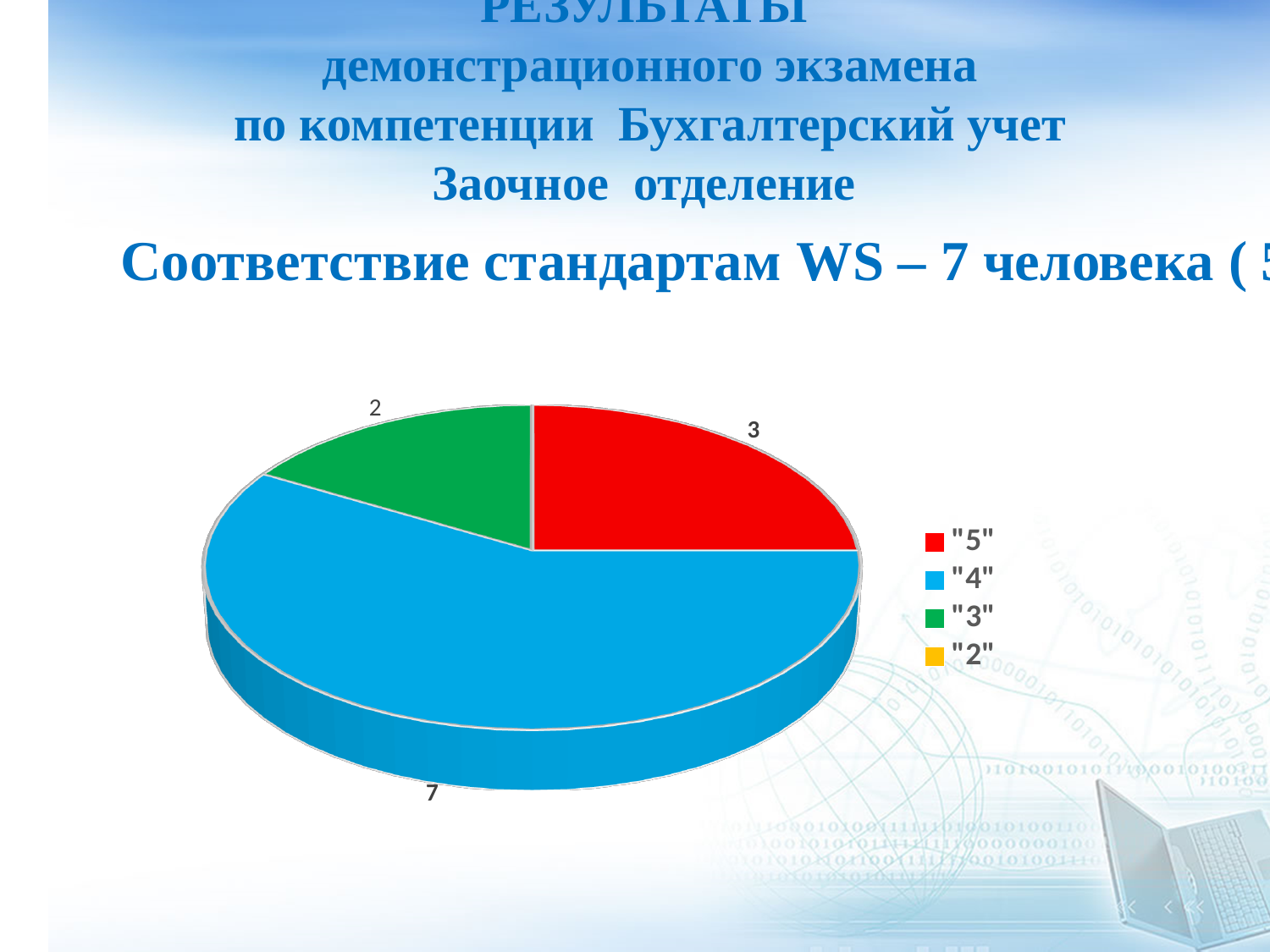
What is the value of the "5" slice in the pie chart? 3 Which slice is larger, "5" or "3"? "5" What is the value of the "3" slice in the pie chart? 2 How many slices with data labels are visible in the pie chart? 3 What share of the pie does the "5" slice represent? 25% What type of chart is shown on the slide? pie chart Which grade has the largest slice in the pie chart? "4" What is the value of the "4" slice in the pie chart? 7 How many entries does the legend of the pie chart list? 4 What is the difference between the values of the "4" slice and the "5" slice? 4 Which of the visible slices in the pie chart is the smallest? "3" What colour is the "4" slice in the pie chart? blue